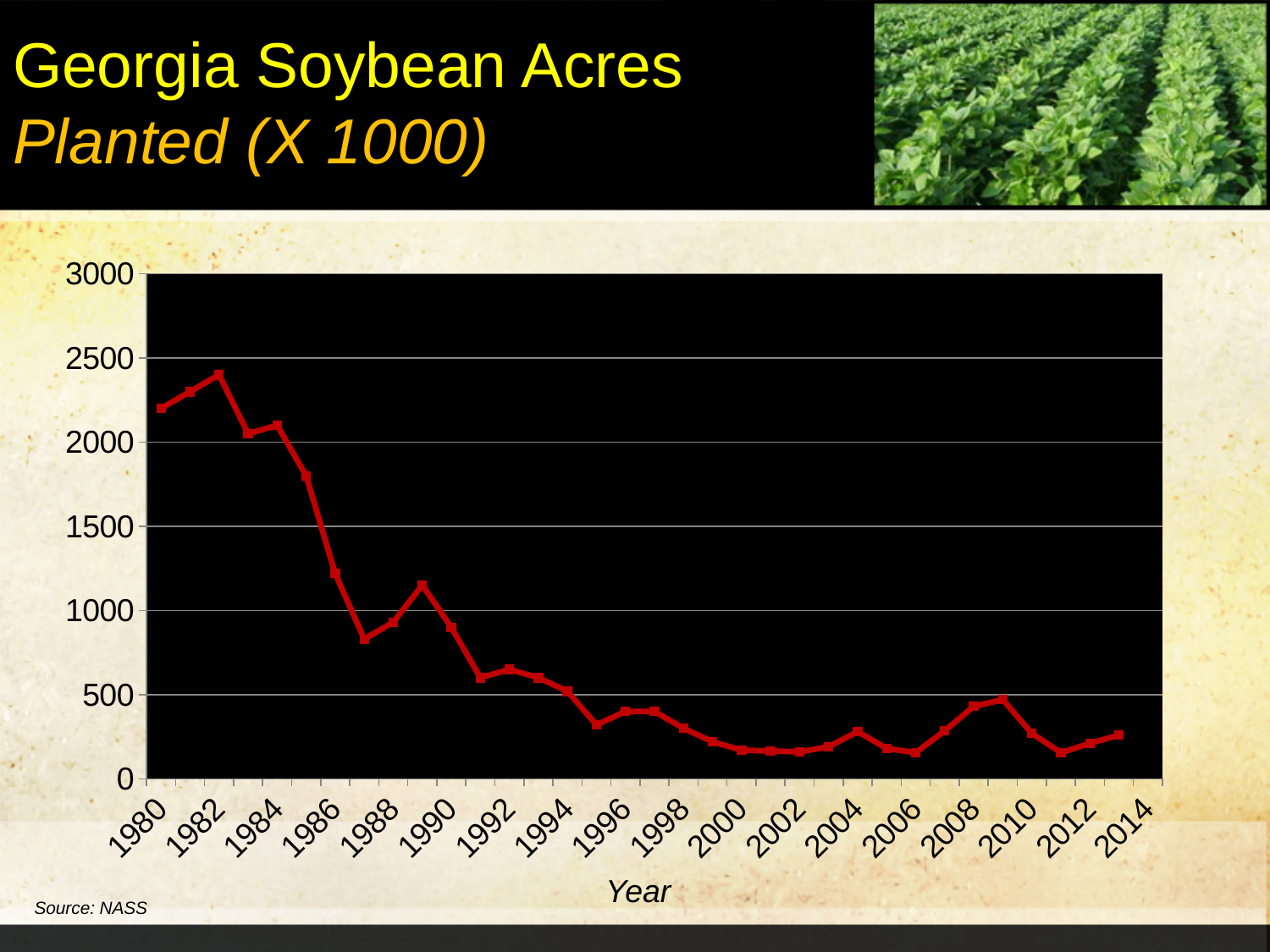
What kind of chart is shown on the slide? line chart What is the label of the x axis? Year Which year has the larger value, 1980 or 2000? 1980 Is the value for 2012 greater or less than 500? less Is the value for 1980 greater or less than 2000? greater Overall, do the values rise or fall from 1980 to 2014? fall Is the value for 1986 greater or less than 1000? greater Which year has the highest value of soybean acres planted? 1982 Which year has the larger value, 1984 or 1988? 1984 What is the title of the chart on the slide? Georgia Soybean Acres Planted (X 1000)